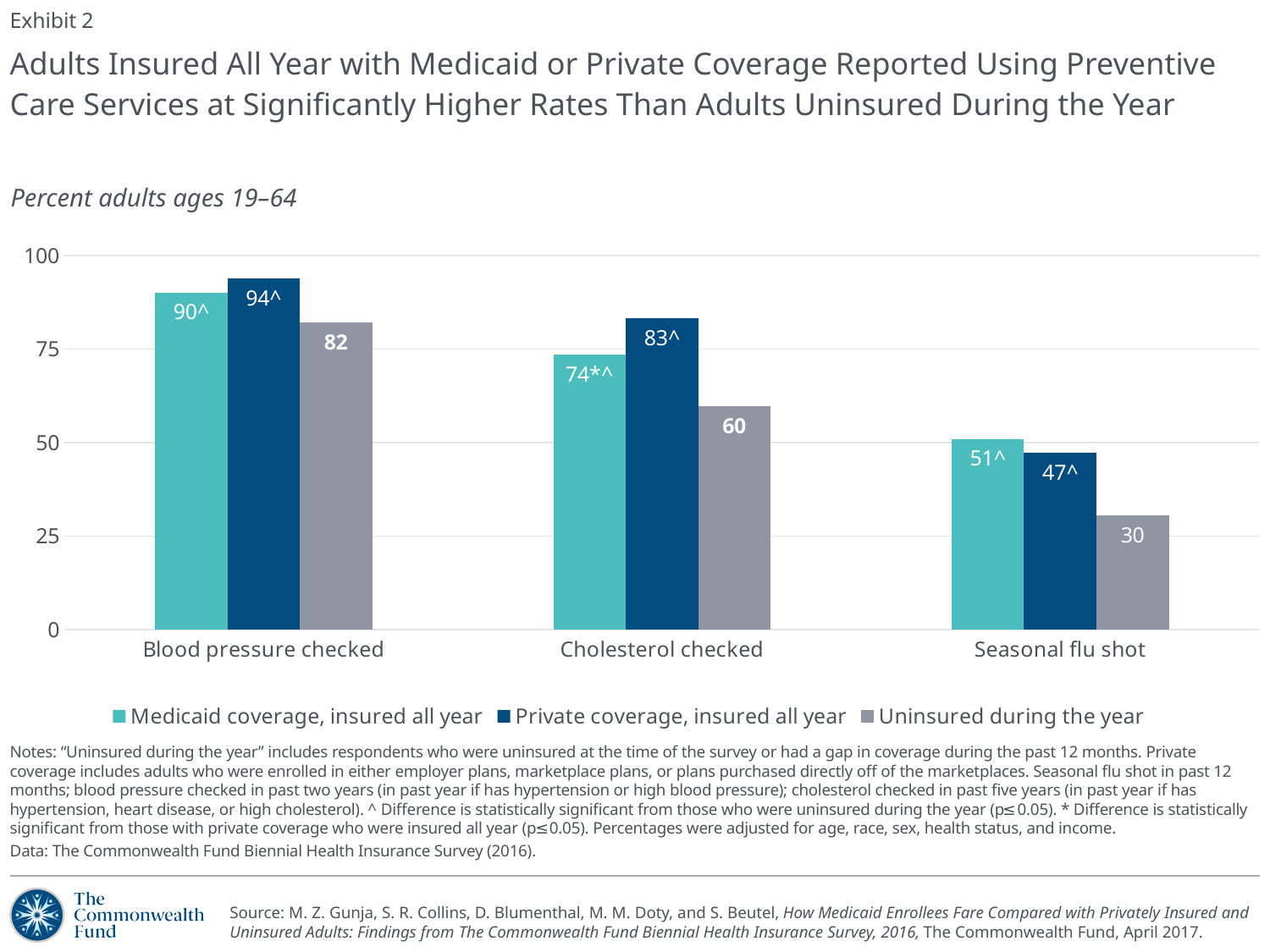
What kind of chart is shown on the slide? Bar chart For Seasonal flu shot, which is larger: the Medicaid coverage value or the Private coverage value? Medicaid coverage, insured all year How many preventive care service categories are shown on the x axis? 3 What is the value for Medicaid coverage, insured all year, for Blood pressure checked? 90 Which coverage group has the lowest value for Seasonal flu shot? Uninsured during the year How many series does the legend list? 3 What is the value for Private coverage, insured all year, for Seasonal flu shot? 47 Which coverage group has the highest value for Blood pressure checked? Private coverage, insured all year Do the Uninsured during the year values rise or fall from Blood pressure checked to Seasonal flu shot? Fall What is the y-axis label shown above the chart? Percent adults ages 19–64 What is the difference between the Private coverage and Uninsured values for Cholesterol checked? 23 What is the value for Uninsured during the year for Cholesterol checked? 60